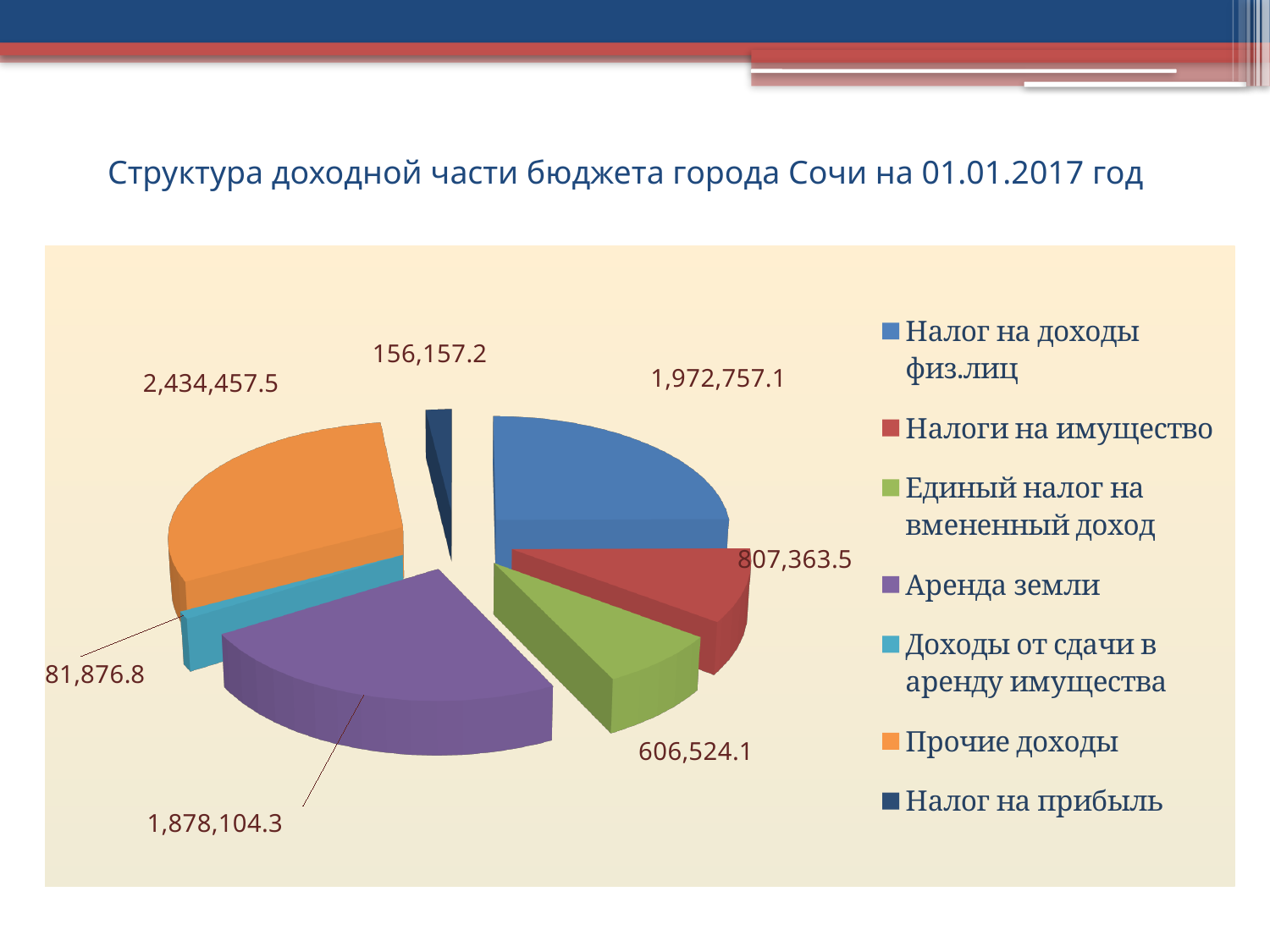
What is the title of the slide? Структура доходной части бюджета города Сочи на 01.01.2017 год What is the value for Налог на доходы физ.лиц? 1,972,757.1 How many categories does the pie chart have? 7 Which category has the smallest slice of the pie? Доходы от сдачи в аренду имущества What is the difference between the values for Прочие доходы and Налог на доходы физ.лиц? 461,700.4 What is the value for Налог на прибыль? 156,157.2 What is the value for Аренда земли? 1,878,104.3 What is the difference between the values for Налоги на имущество and Единый налог на вмененный доход? 200,839.4 Which is larger, Налог на доходы физ.лиц or Аренда земли? Налог на доходы физ.лиц What type of chart is shown on the slide? Pie chart What is the value for Прочие доходы? 2,434,457.5 Which category has the largest slice of the pie? Прочие доходы